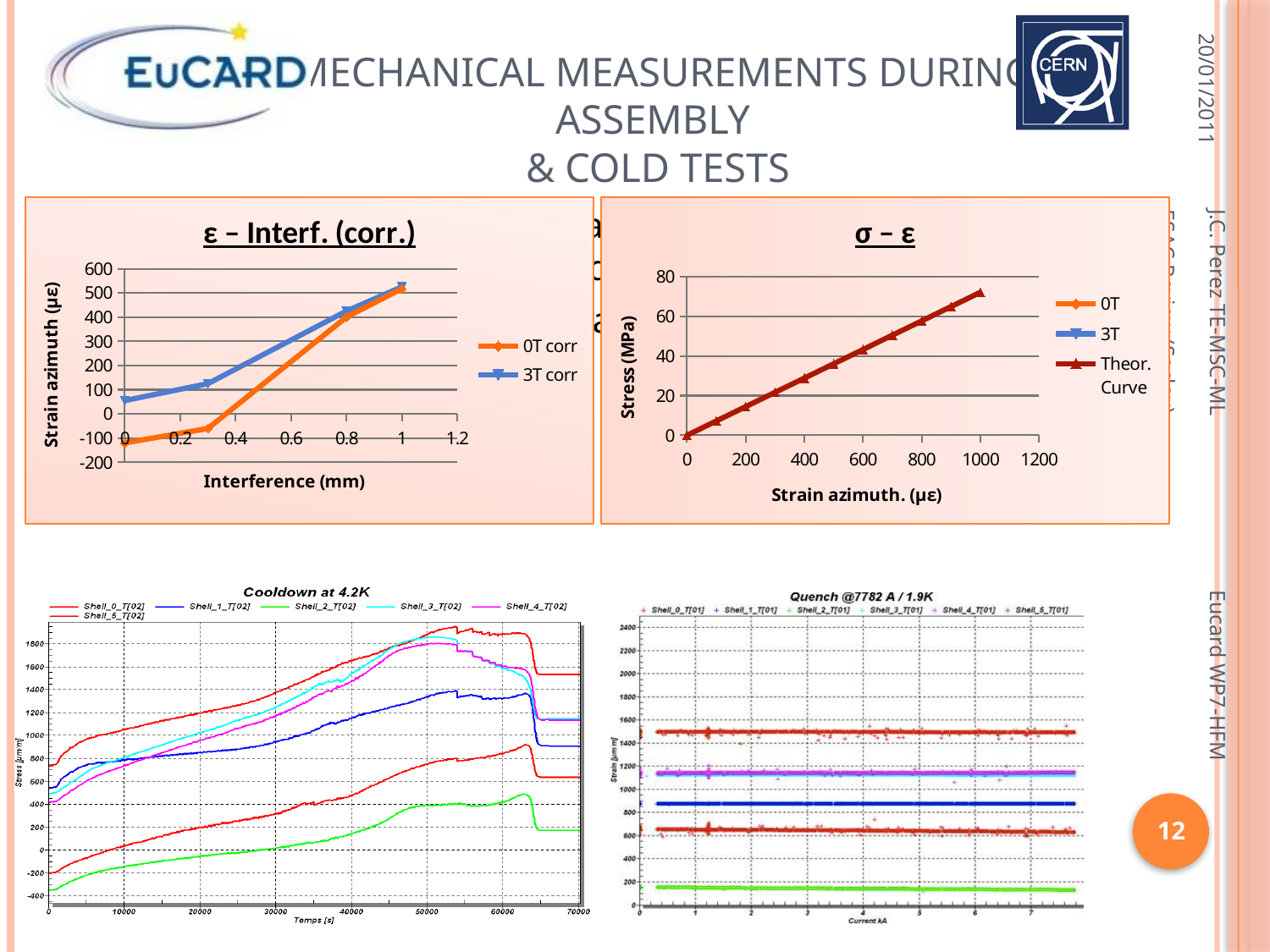
What kind of chart is the "ε – Interf. (corr.)" chart? line chart In the "ε – Interf. (corr.)" chart, is the value of 0T corr at interference 0.2 greater or less than 0? less What is the x-axis title of the "ε – Interf. (corr.)" chart? Interference (mm) In the "ε – Interf. (corr.)" chart, is the value of 3T corr at interference 0 greater or less than 0? greater How many series does the legend of the "σ – ε" chart list? 3 How many series does the legend of the "Cooldown at 4.2K" chart list? 6 In the "σ – ε" chart, is the stress of the Theor. Curve at strain 1000 greater or less than 60? greater In the "ε – Interf. (corr.)" chart, at interference 0.2, which series has the larger value, 0T corr or 3T corr? 3T corr What is the y-axis title of the "σ – ε" chart? Stress (MPa) In the "σ – ε" chart, does the Theor. Curve rise or fall as strain increases? rises How many series does the legend of the "ε – Interf. (corr.)" chart list? 2